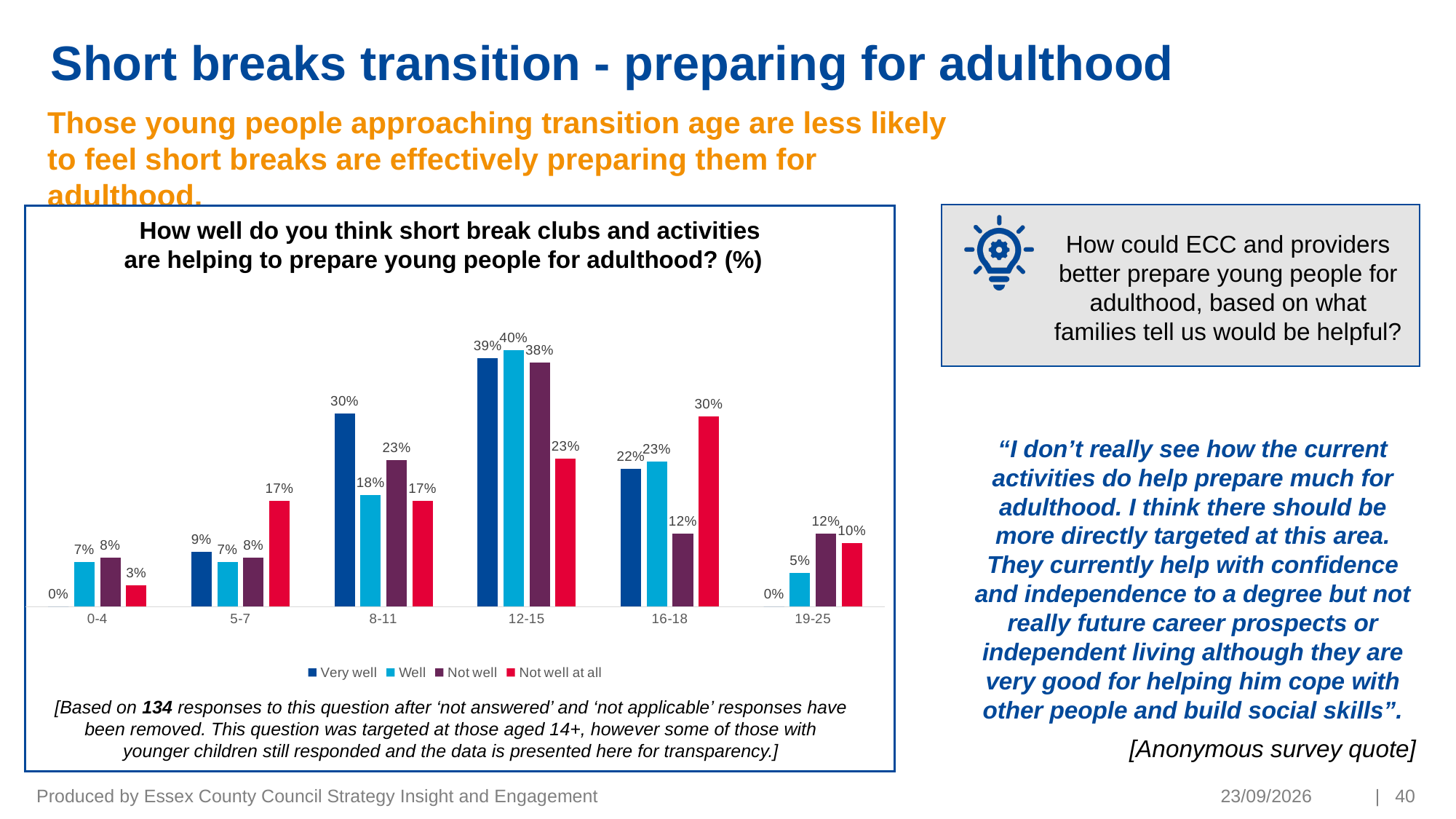
In the 16-18 age group, which is larger: 'Not well' or 'Not well at all'? Not well at all What kind of chart is shown on the slide? Bar chart What is the difference between the 'Not well' and 'Not well at all' values in the 19-25 age group? 2% How many age groups are shown on the x axis? 6 What is the value for 'Very well' in the 8-11 age group? 30% Which series is shown in red in the legend? Not well at all Which age group has the lowest value for 'Not well at all'? 0-4 What is the difference between the 'Very well' values for the 8-11 and 12-15 age groups? 9% What is the value for 'Not well at all' in the 16-18 age group? 30% How many series does the legend list? 4 What is the value for 'Well' in the 19-25 age group? 5% Which age group has the highest value for 'Well'? 12-15